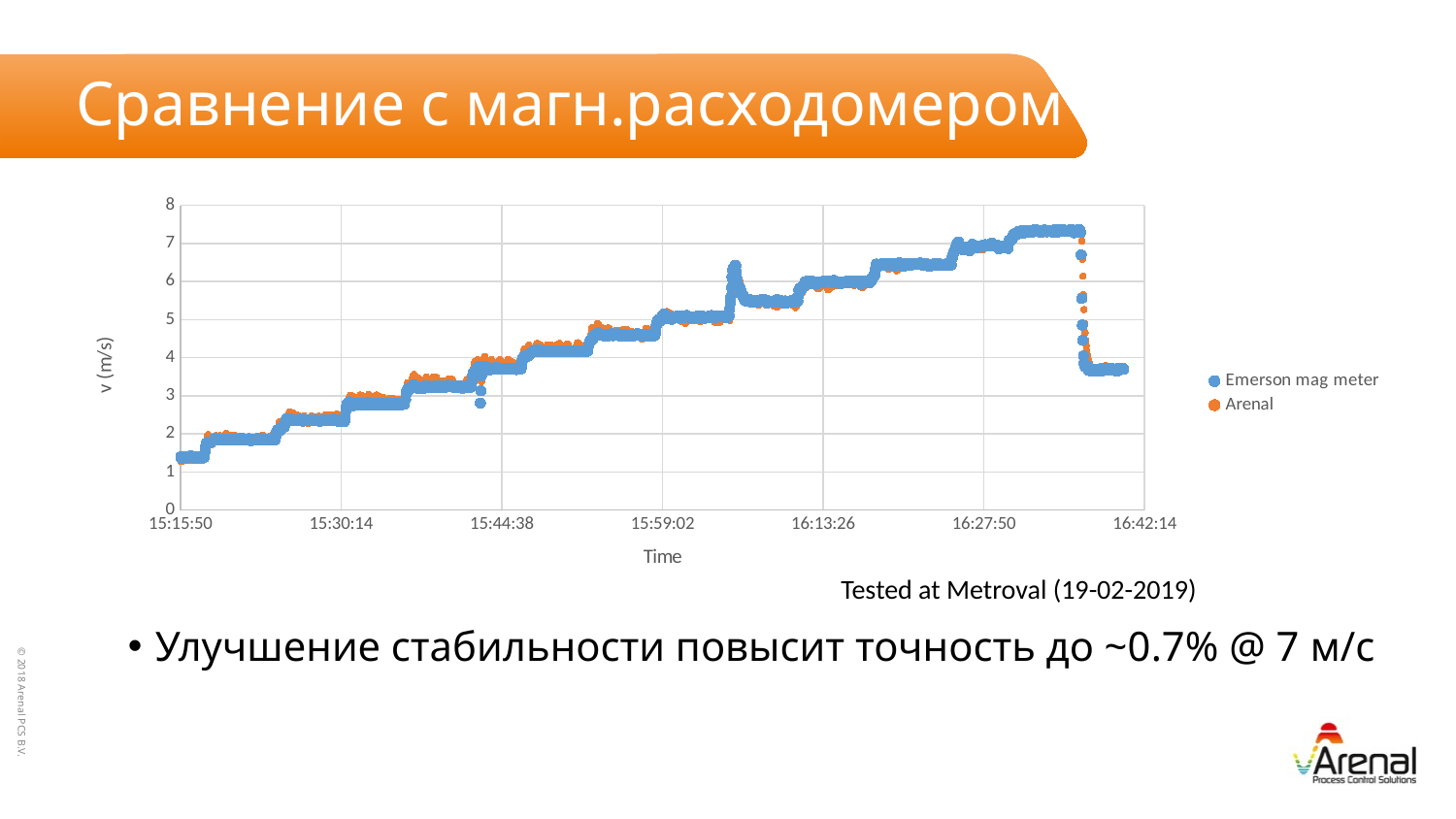
Do the plotted velocity values generally rise or fall from 15:15:50 up to around 16:35? Rise What kind of chart is shown on the slide? Scatter chart Is the velocity value at the very end of the chart (after the sharp drop) greater or less than 3 m/s? greater Is the velocity value at 16:27:50 greater or less than 6 m/s? greater What is the label of the vertical axis of the chart? v (m/s) What are the two series named in the chart legend? Emerson mag meter and Arenal How many series does the chart legend list? 2 Is the velocity value at 15:59:02 greater or less than 4 m/s? greater What is the maximum value shown on the vertical axis of the chart? 8